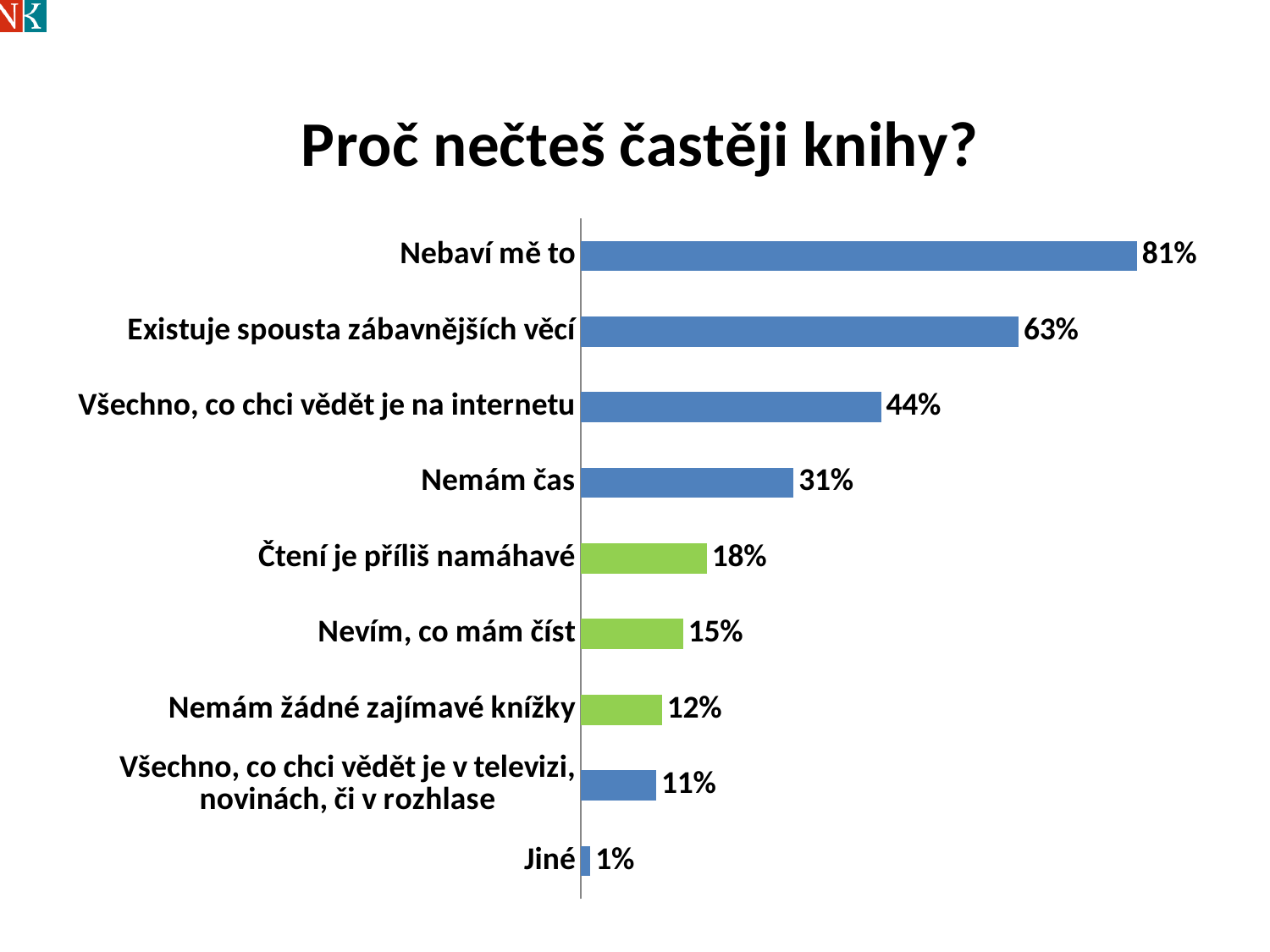
Which category has the lowest value? Jiné Which category has the highest value? Nebaví mě to What is the title of the chart? Proč nečteš častěji knihy? What is the value for "Nemám čas"? 31% What is the difference between "Existuje spousta zábavnějších věcí" and "Všechno, co chci vědět je na internetu"? 19% What is the difference between "Čtení je příliš namáhavé" and "Nemám žádné zajímavé knížky"? 6% Which is larger: "Nemám čas" or "Čtení je příliš namáhavé"? Nemám čas What is the value for "Nevím, co mám číst"? 15% What kind of chart is shown on the slide? Bar chart How many categories are shown in the chart? 9 What is the value for "Všechno, co chci vědět je v televizi, novinách, či v rozhlase"? 11% What is the value for "Nebaví mě to"? 81%